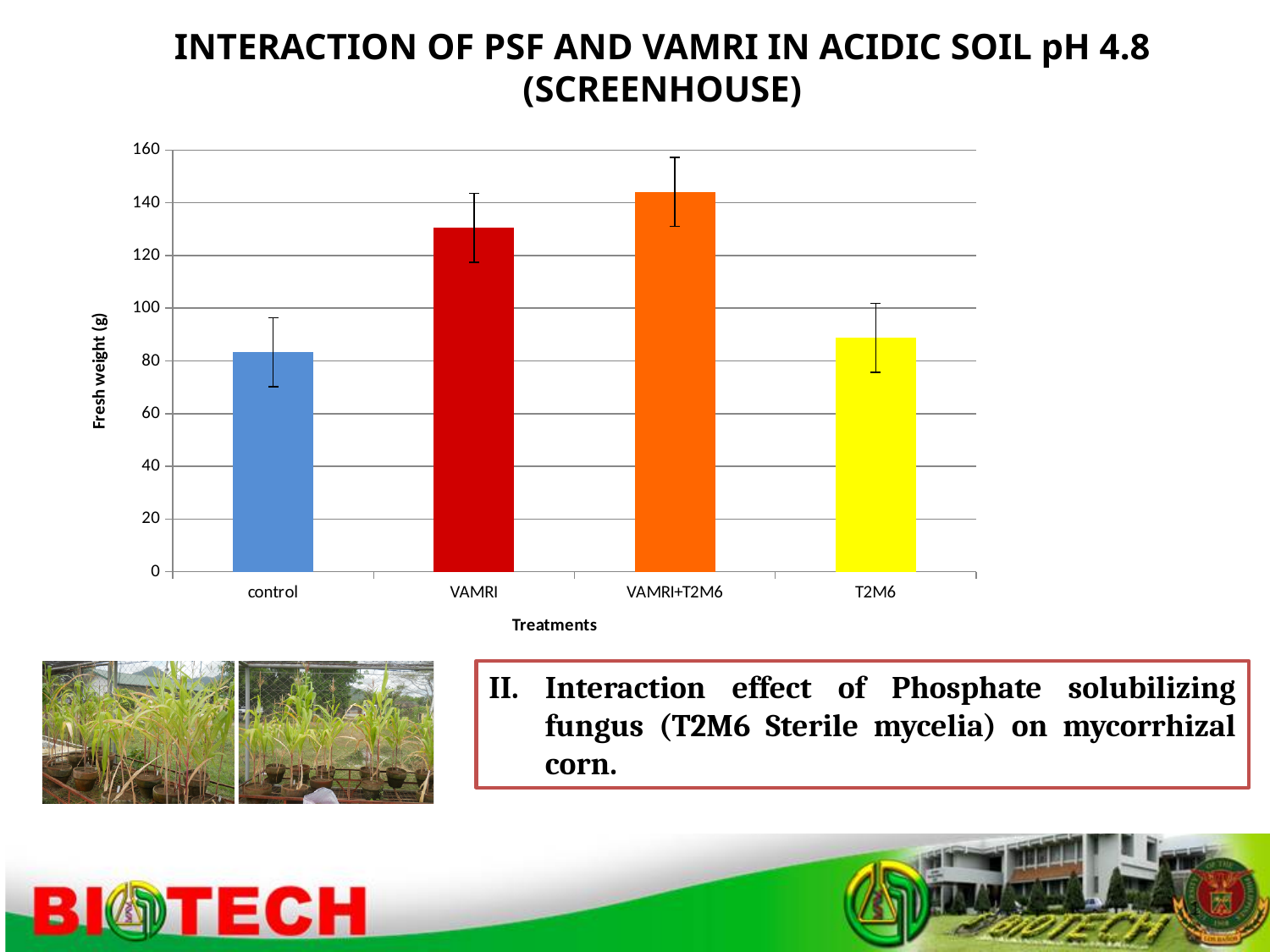
Is the fresh weight for VAMRI greater or less than 140? less Which treatment has the highest fresh weight? VAMRI+T2M6 Is the fresh weight for VAMRI+T2M6 greater or less than 140? greater Is the fresh weight for control greater or less than 100? less Which has a higher fresh weight, VAMRI or control? VAMRI Which has a higher fresh weight, VAMRI+T2M6 or T2M6? VAMRI+T2M6 What is the label of the y axis? Fresh weight (g) What colour is the bar for VAMRI+T2M6? orange How many treatments are plotted on the x axis? 4 What kind of chart is shown on the slide? bar chart